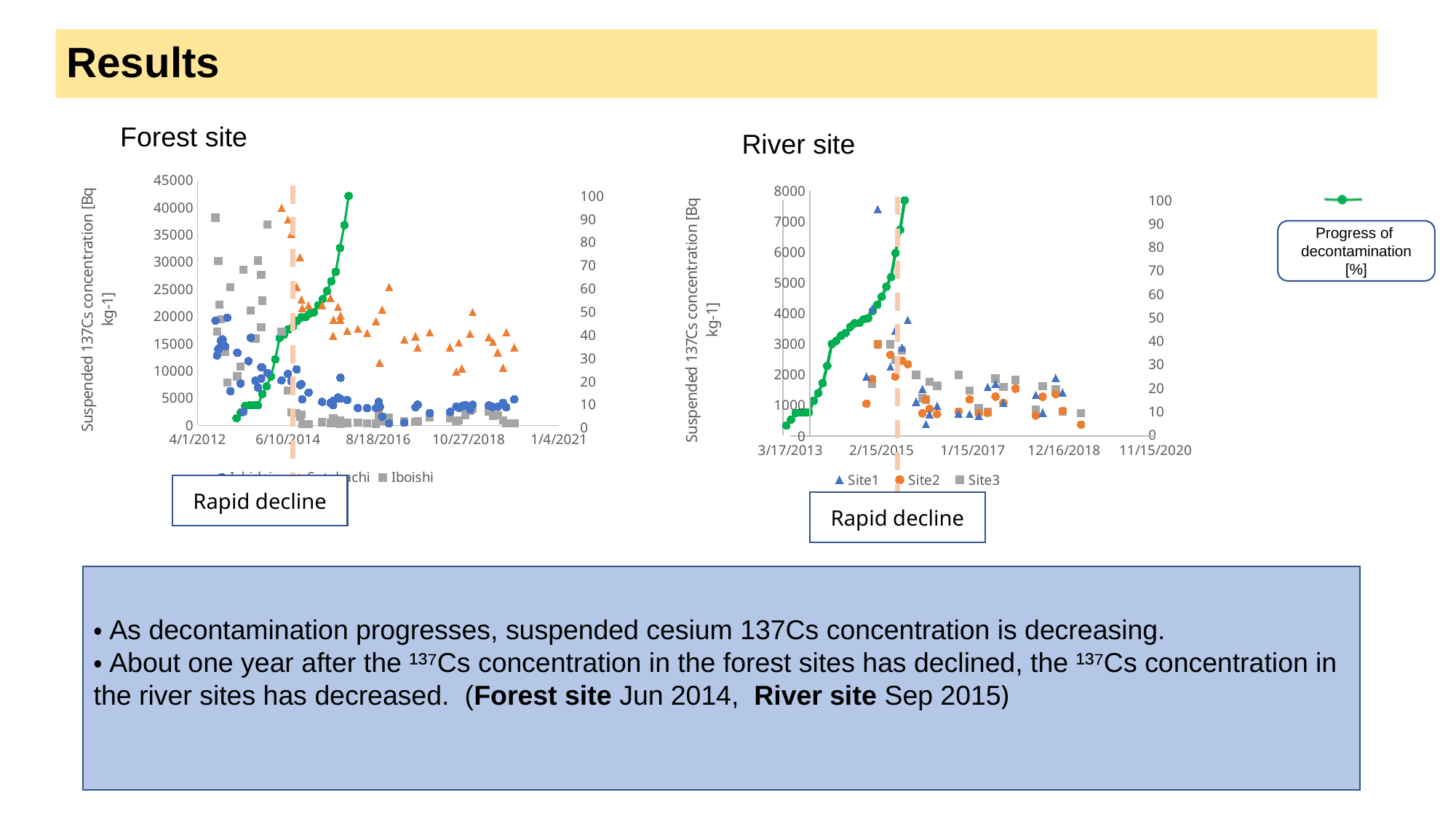
In the River site chart, does the green progress of decontamination line rise or fall over time? rise What kind of chart is the River site chart? scatter chart In the River site chart, is the final value of the green progress of decontamination line greater or less than 90? greater How many series does the legend of the River site chart list? 3 What is the first date label on the x-axis of the River site chart? 3/17/2013 In the Forest site chart, does the green progress of decontamination line rise or fall over time? rise What is the last date label on the x-axis of the Forest site chart? 1/4/2021 What is the highest tick value on the left y-axis of the River site chart? 8000 What kind of chart is the Forest site chart? scatter chart